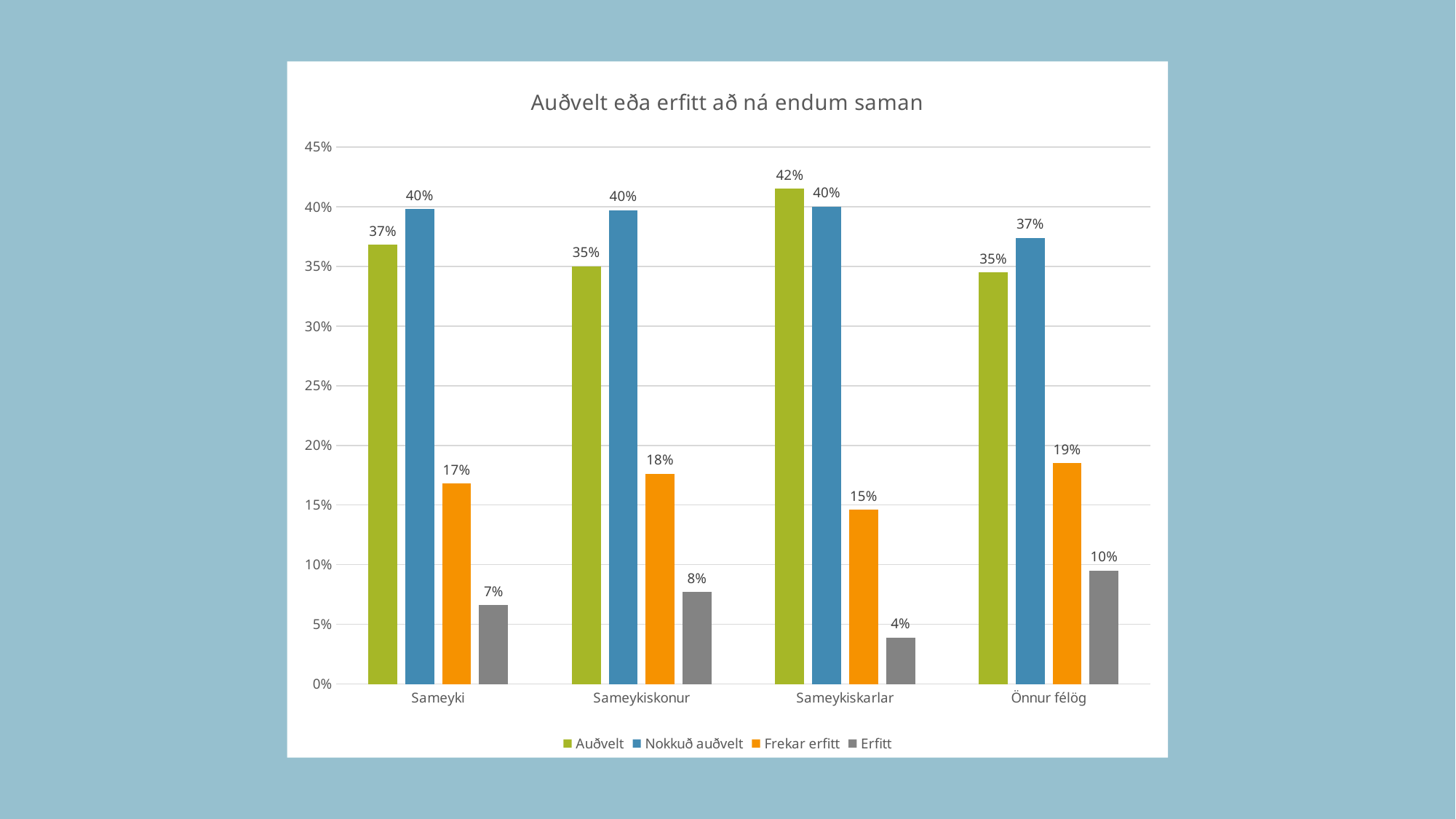
What is the value for Nokkuð auðvelt in the Sameyki category? 40% What is the difference between the Frekar erfitt value and the Erfitt value in the Sameyki category? 10% Which is larger in the Önnur félög category: Auðvelt or Nokkuð auðvelt? Nokkuð auðvelt What is the value for Erfitt in the Sameykiskonur category? 8% What kind of chart is shown on the slide? Bar chart Which category has the highest value for Auðvelt? Sameykiskarlar How many categories are shown on the x axis? 4 Which category has the lowest value for Erfitt? Sameykiskarlar What is the value for Auðvelt in the Sameykiskarlar category? 42% What is the value for Frekar erfitt in the Önnur félög category? 19% What is the title of the chart? Auðvelt eða erfitt að ná endum saman How many series does the legend list? 4